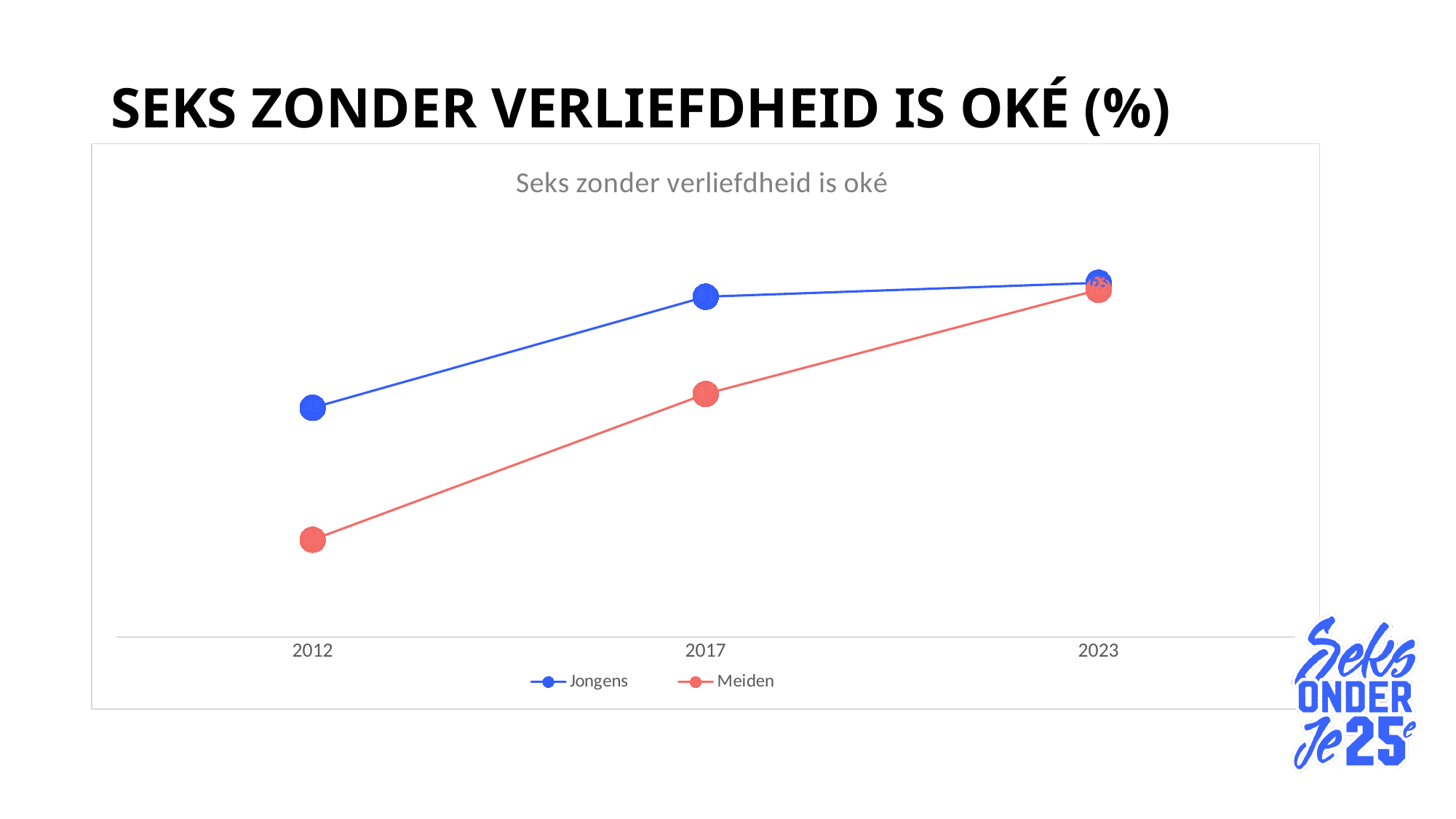
Do the values for Meiden rise or fall from 2012 to 2023? rise How many years are shown on the x axis? 3 In 2012, which series has the higher value, Jongens or Meiden? Jongens What kind of chart is shown on the slide? line chart What is the title shown inside the chart area? Seks zonder verliefdheid is oké Which series is plotted in blue? Jongens In which year is the value for Meiden highest? 2023 How many series does the legend list? 2 In 2017, which series has the higher value, Jongens or Meiden? Jongens Do the values for Jongens rise or fall from 2012 to 2023? rise In which year is the value for Meiden lowest? 2012 In which year is the value for Jongens lowest? 2012